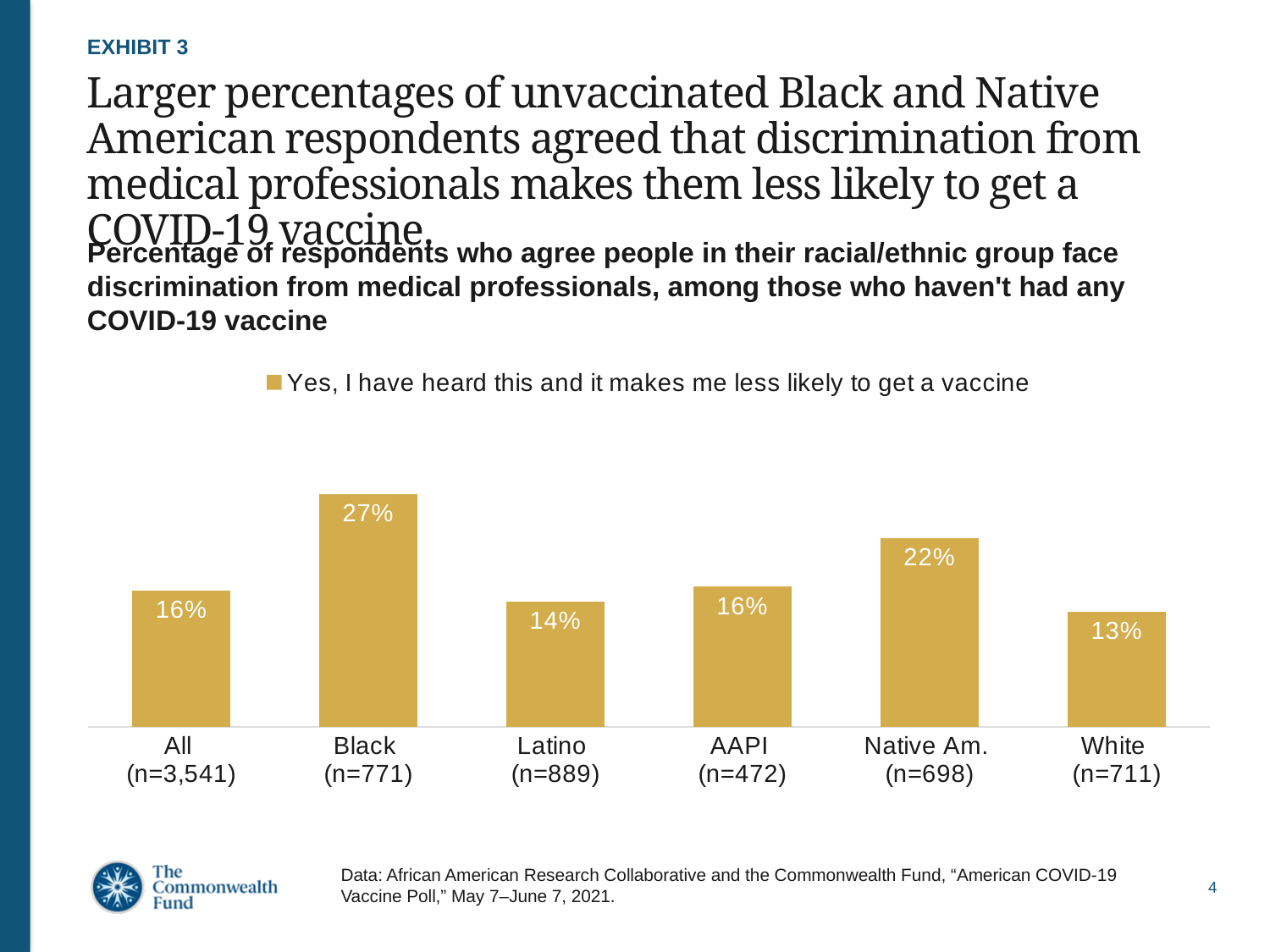
What is the value shown for All (n=3,541)? 16% What is the difference in percentage points between Black (n=771) and White (n=711)? 14 percentage points What is the legend entry for the series shown in the chart? Yes, I have heard this and it makes me less likely to get a vaccine What is the difference in percentage points between Native Am. (n=698) and Latino (n=889)? 8 percentage points What kind of chart is shown on the slide? Bar chart What is the value shown for White (n=711)? 13% Which group has the lowest percentage in the chart? White (n=711) What is the value shown for Native Am. (n=698)? 22% Which is larger, the value for Native Am. (n=698) or the value for AAPI (n=472)? Native Am. (n=698) What percentage of unvaccinated Black respondents (n=771) agreed that discrimination from medical professionals makes them less likely to get a vaccine? 27% How many groups are shown on the x axis of the chart? 6 Which group has the highest percentage in the chart? Black (n=771)